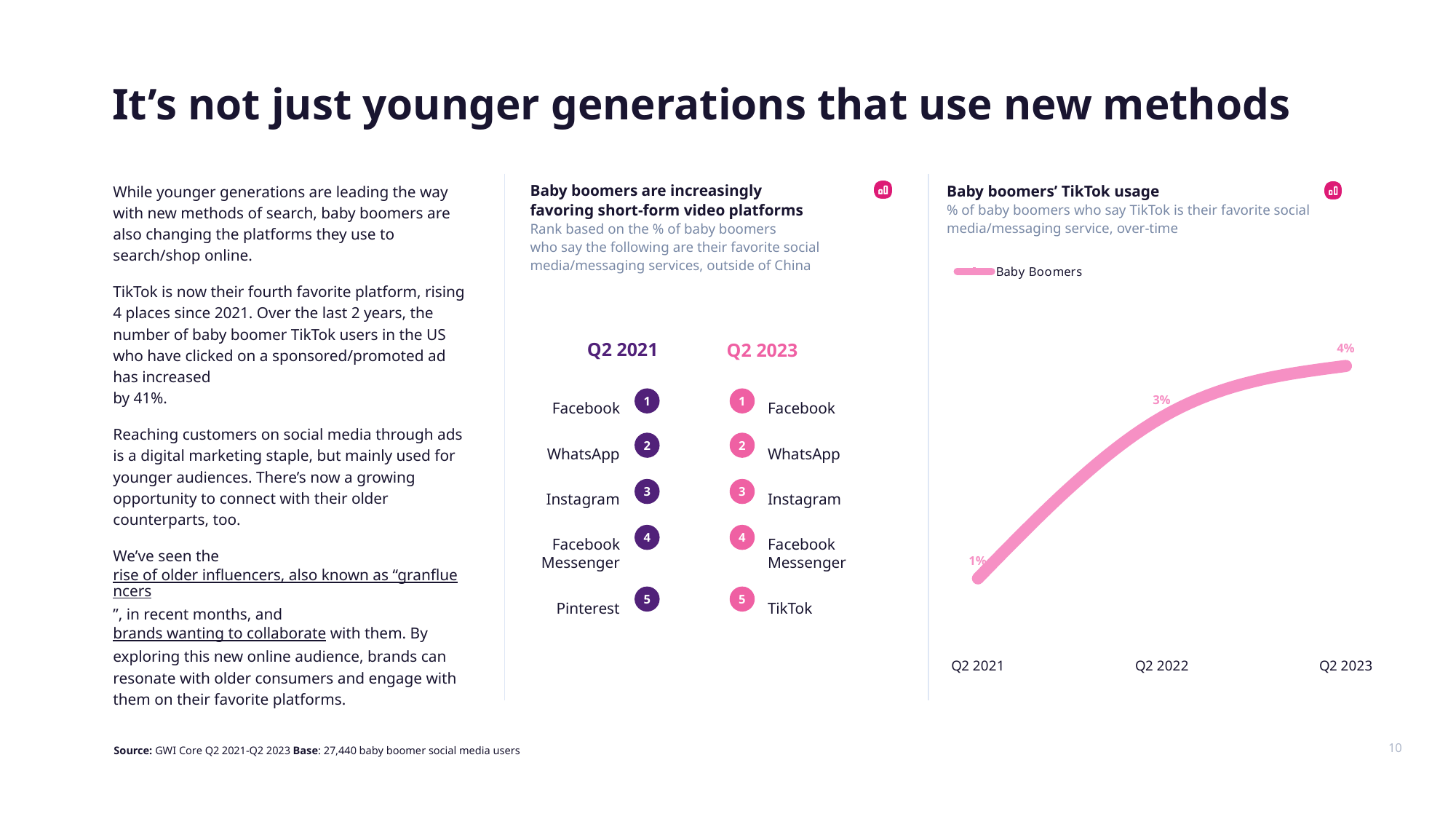
In the 'Baby boomers' TikTok usage' chart, what is the difference between the Q2 2022 and Q2 2021 values? 2% In the 'Baby boomers' TikTok usage' chart, do the values rise or fall from Q2 2021 to Q2 2023? Rise What kind of chart is 'Baby boomers' TikTok usage'? Line chart In the 'Baby boomers' TikTok usage' chart, what is the value for Q2 2023? 4% In the 'Baby boomers' TikTok usage' chart, what is the value for Q2 2022? 3% In the 'Baby boomers' TikTok usage' chart, how many series does the legend list? 1 In the 'Baby boomers' TikTok usage' chart, which is larger, the value for Q2 2022 or Q2 2023? Q2 2023 In the 'Baby boomers' TikTok usage' chart, what is the difference between the Q2 2023 and Q2 2021 values? 3% In the 'Baby boomers' TikTok usage' chart, what is the value for Q2 2021? 1% In the 'Baby boomers' TikTok usage' chart, how many data points are plotted? 3 In the 'Baby boomers' TikTok usage' chart, which period has the highest value? Q2 2023 In the 'Baby boomers' TikTok usage' chart, which period has the lowest value? Q2 2021